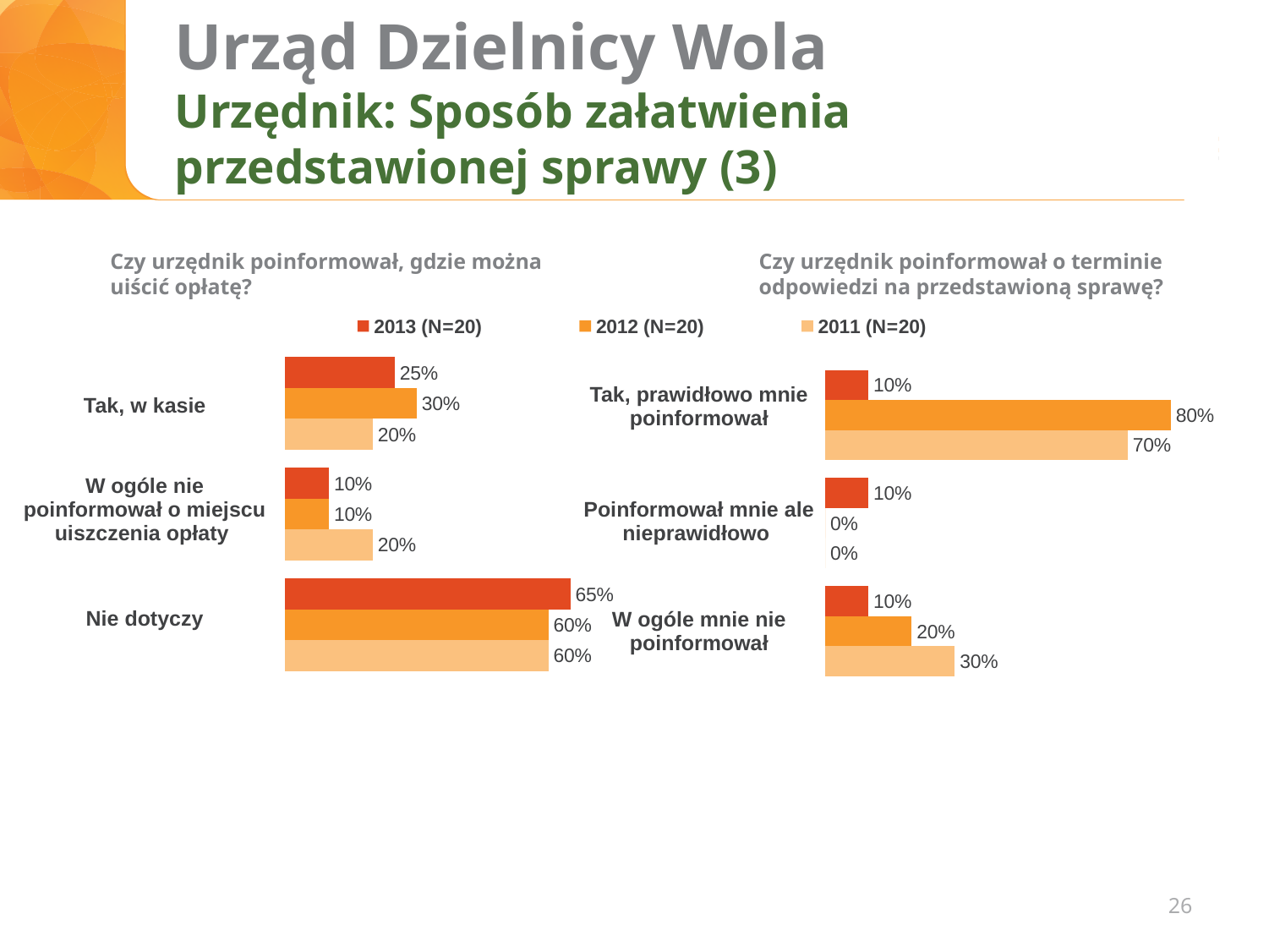
What kind of chart is the right chart ("Czy urzędnik poinformował o terminie odpowiedzi na przedstawioną sprawę?")? Bar chart In the left chart ("Czy urzędnik poinformował, gdzie można uiścić opłatę?"), what is the value for "Nie dotyczy" in 2012 (N=20)? 60% In the left chart ("Czy urzędnik poinformował, gdzie można uiścić opłatę?"), what is the value for "Tak, w kasie" in 2013 (N=20)? 25% In the right chart ("Czy urzędnik poinformował o terminie odpowiedzi na przedstawioną sprawę?"), what is the value for "W ogóle mnie nie poinformował" in 2011 (N=20)? 30% In the right chart ("Czy urzędnik poinformował o terminie odpowiedzi na przedstawioną sprawę?"), what is the value for "Tak, prawidłowo mnie poinformował" in 2012 (N=20)? 80% In the right chart ("Czy urzędnik poinformował o terminie odpowiedzi na przedstawioną sprawę?"), which category has the lowest value for 2011 (N=20)? Poinformował mnie ale nieprawidłowo In the left chart ("Czy urzędnik poinformował, gdzie można uiścić opłatę?"), which category has the highest value for 2013 (N=20)? Nie dotyczy How many categories does the left chart ("Czy urzędnik poinformował, gdzie można uiścić opłatę?") show? 3 In the left chart ("Czy urzędnik poinformował, gdzie można uiścić opłatę?"), which is larger for "Tak, w kasie": the 2012 (N=20) value or the 2011 (N=20) value? 2012 (N=20) In the right chart ("Czy urzędnik poinformował o terminie odpowiedzi na przedstawioną sprawę?"), what is the difference between the 2012 (N=20) and 2013 (N=20) values for "Tak, prawidłowo mnie poinformował"? 70% How many series does the legend list? 3 In the right chart ("Czy urzędnik poinformował o terminie odpowiedzi na przedstawioną sprawę?"), what is the difference between the 2011 (N=20) and 2012 (N=20) values for "W ogóle mnie nie poinformował"? 10%